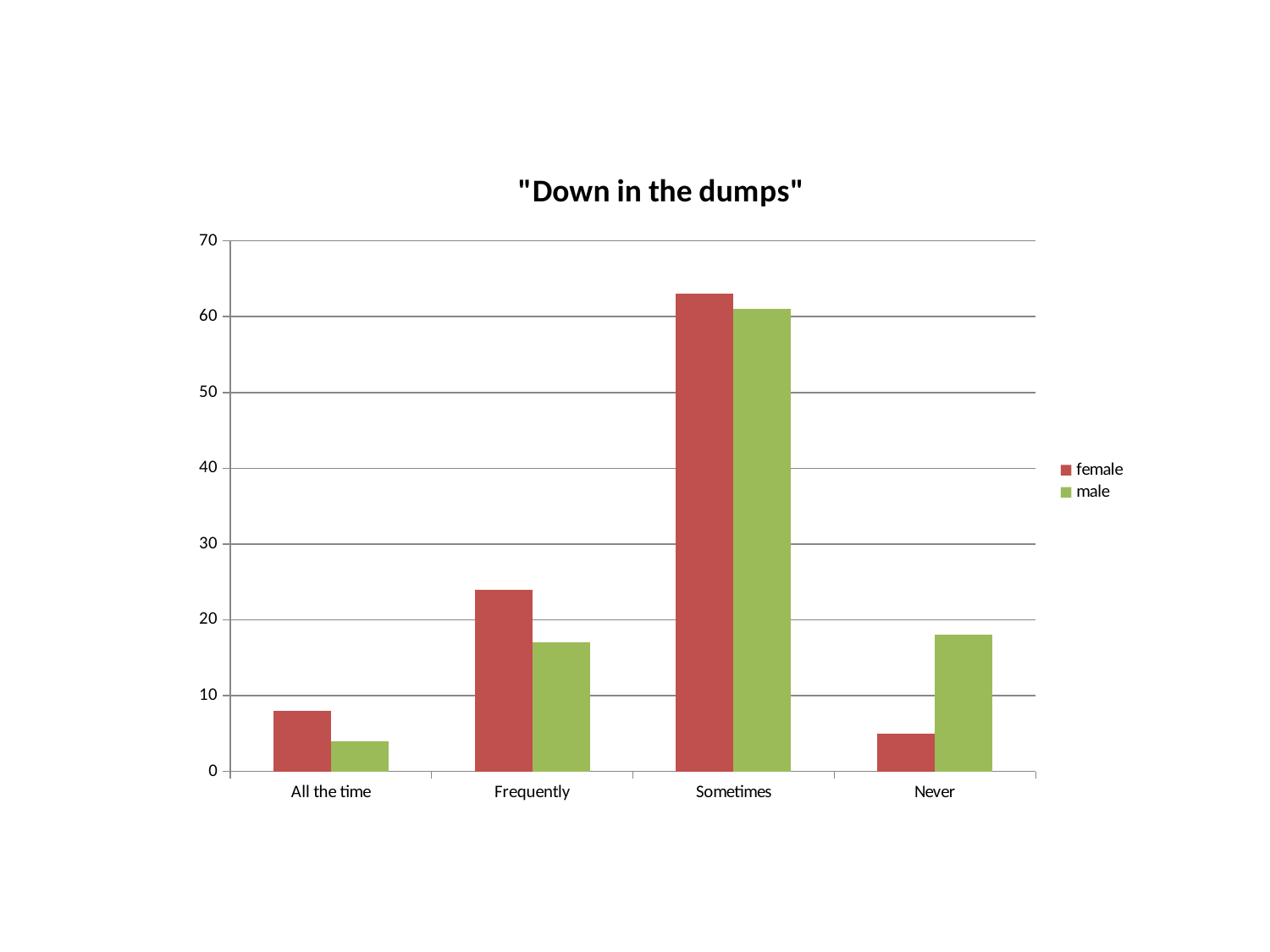
Is the female value for Frequently greater or less than 20? greater How many categories are shown on the x axis? 4 Is the male value for Frequently greater or less than 20? less Is the male value for Never greater or less than 10? greater For the Never category, which is larger, the female value or the male value? male How many series does the legend list? 2 Which category has the lowest male value? All the time What type of chart is shown on the slide? bar chart Which category has the highest female value? Sometimes What is the title of the chart? "Down in the dumps" Which category has the lowest female value? Never